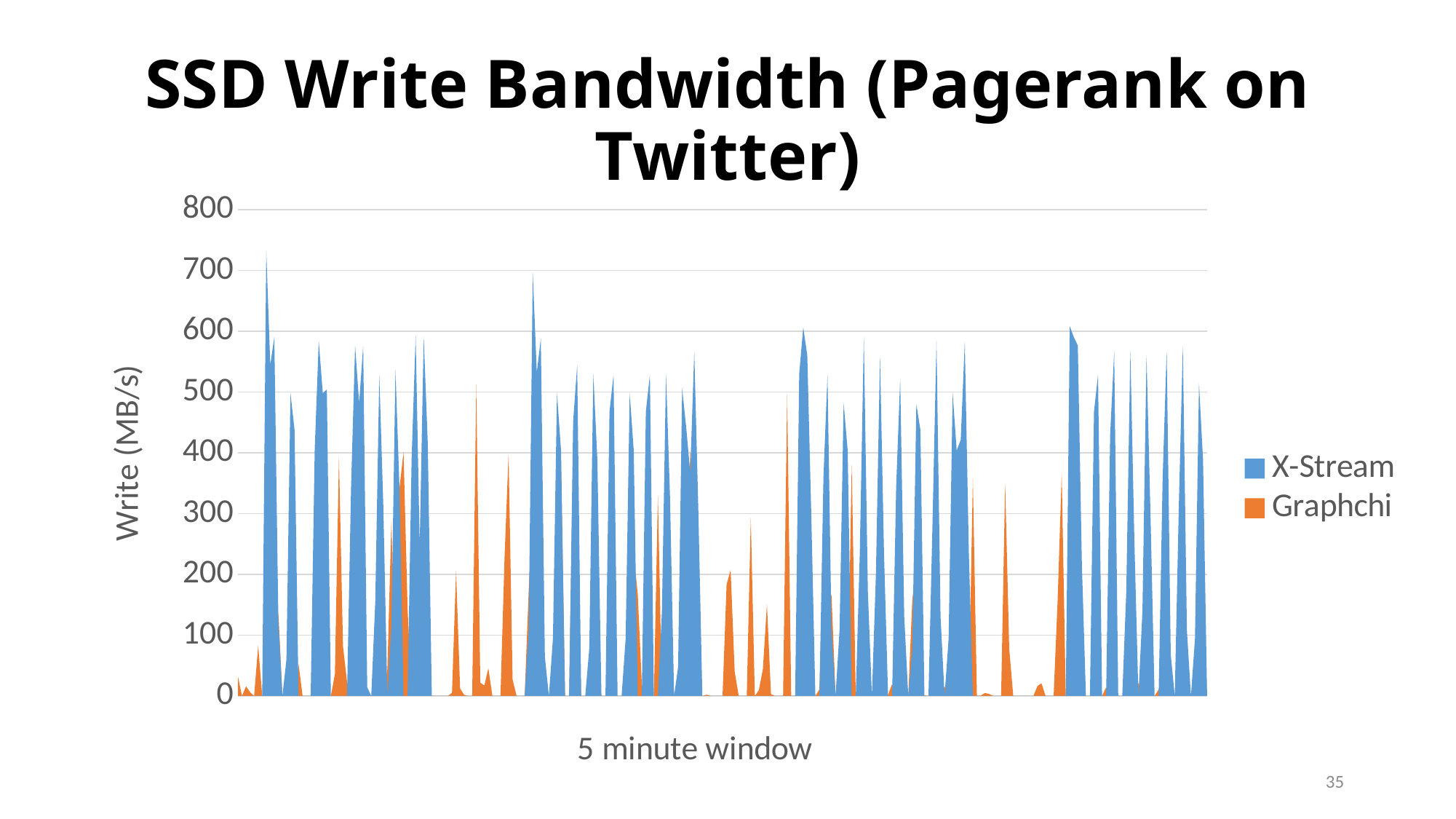
What kind of chart is shown on the slide? Area chart Which series has the lower maximum write bandwidth? Graphchi What is the label of the y axis? Write (MB/s) What is the highest value shown on the y axis? 800 How many series does the legend list? 2 Is the highest X-Stream value greater or less than 700? greater Which series reaches the higher peak write bandwidth, X-Stream or Graphchi? X-Stream Is the highest Graphchi value greater or less than 600? less Is the highest Graphchi value greater or less than 400? greater